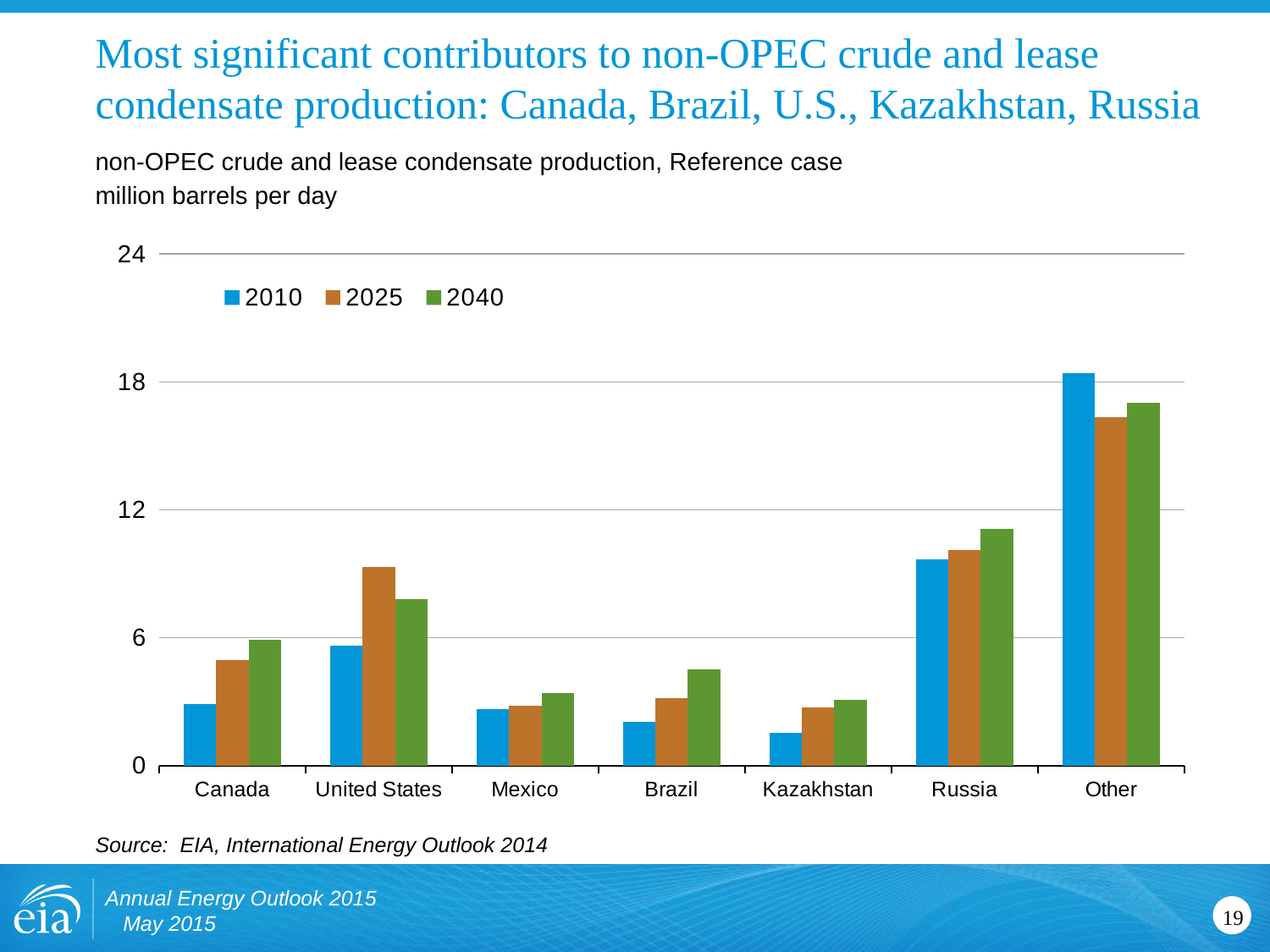
What kind of chart is shown on the slide? bar chart How many categories are shown on the x axis? 7 Which category has the lowest value for 2010? Kazakhstan Is the value for Russia in 2040 greater or less than 12? less For the United States, which is larger: the 2025 value or the 2040 value? 2025 Is the value for Kazakhstan in 2010 greater or less than 6? less What unit is the chart measured in? million barrels per day How many series does the legend list? 3 Do the values for Canada rise or fall from 2010 to 2040? rise Which category has the highest value for 2010? Other Is the value for the United States in 2025 greater or less than 6? greater